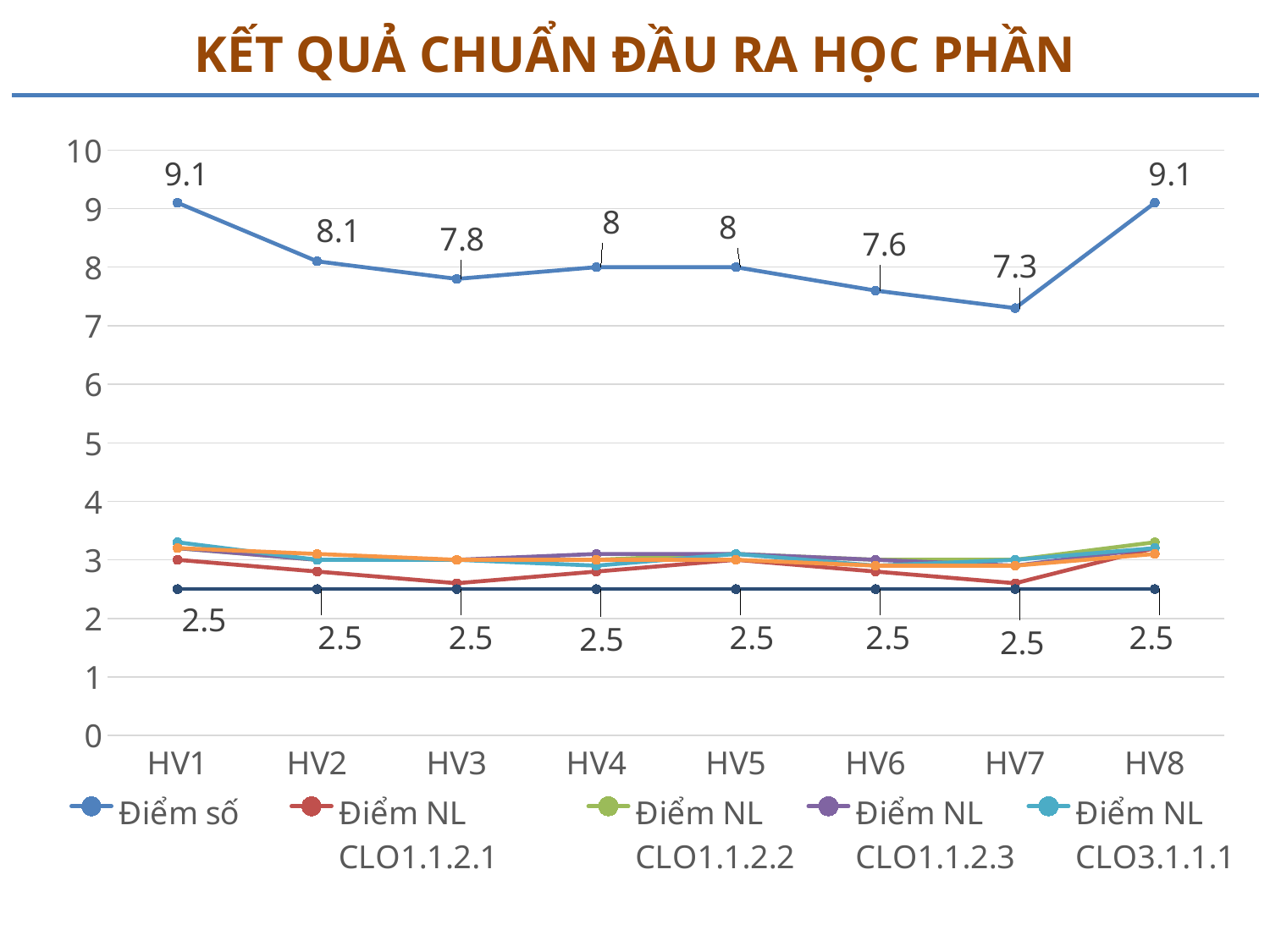
What kind of chart is shown on the slide? line chart What is the value of Điểm số for HV1? 9.1 Which category has the lowest Điểm số value? HV7 What is the difference between the Điểm số values for HV2 and HV3? 0.3 Is the Điểm số value for HV4 greater or less than 7? greater What is the value of Điểm số for HV3? 7.8 How many series does the legend list? 5 What is the difference between the Điểm số values for HV1 and HV7? 1.8 Which has the larger Điểm số value, HV2 or HV6? HV2 Does the Điểm số series rise or fall from HV1 to HV3? fall What is the value of Điểm số for HV7? 7.3 How many categories are shown on the x axis? 8